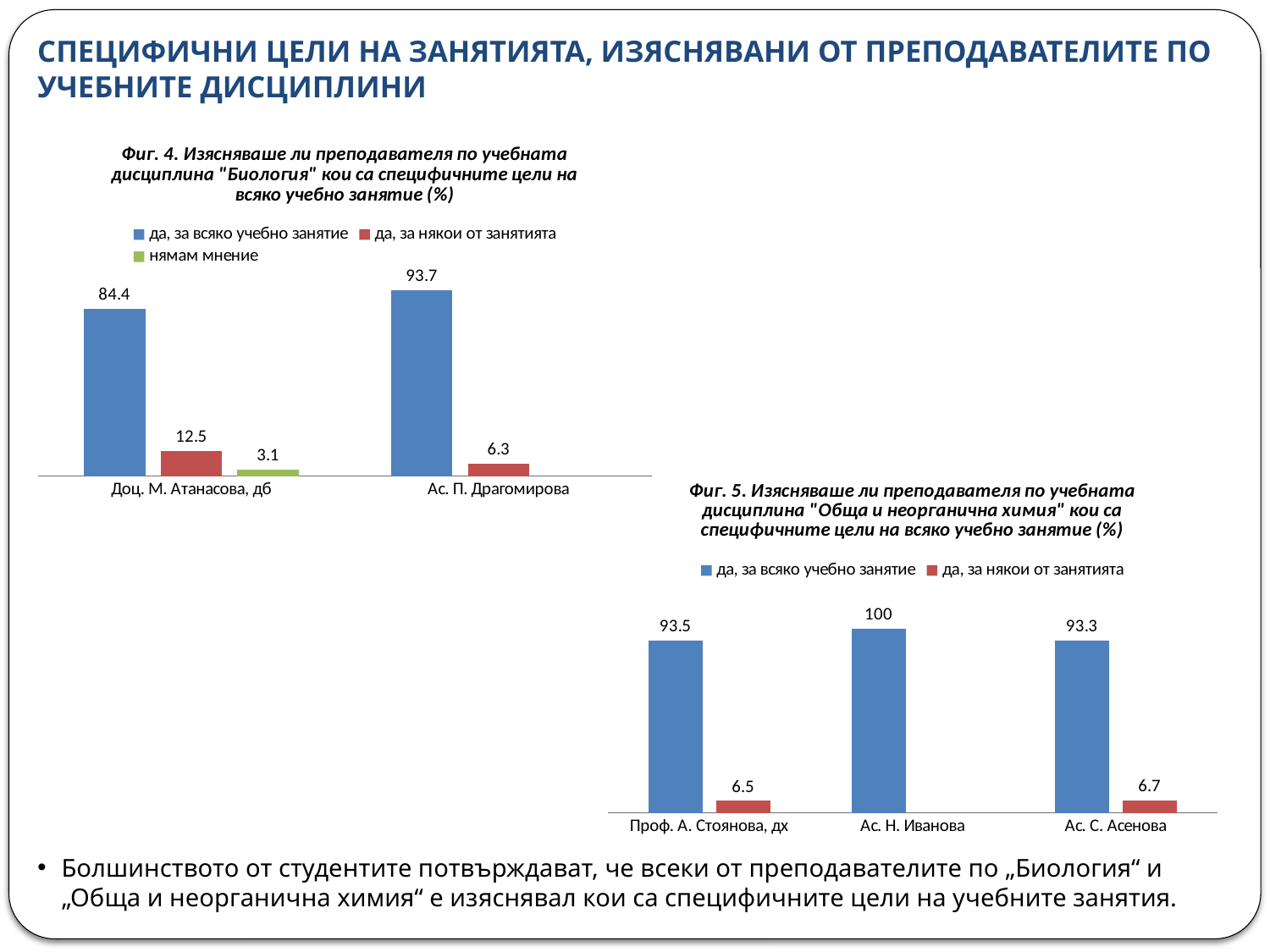
In Фиг. 5 (Обща и неорганична химия), what is the value of "да, за всяко учебно занятие" for Ас. Н. Иванова? 100 How many lecturers (categories) are shown in Фиг. 5 (Обща и неорганична химия)? 3 In Фиг. 4 (Биология), what is the difference between the "да, за всяко учебно занятие" values for Ас. П. Драгомирова and Доц. М. Атанасова, дб? 9.3 What type of chart is Фиг. 5 (Обща и неорганична химия)? Bar chart In Фиг. 4 (Биология), what is the value of "да, за някои от занятията" for Ас. П. Драгомирова? 6.3 In Фиг. 4 (Биология), what is the value of "нямам мнение" for Доц. М. Атанасова, дб? 3.1 In Фиг. 4 (Биология), what is the value of "да, за всяко учебно занятие" for Доц. М. Атанасова, дб? 84.4 How many series does the legend of Фиг. 4 (Биология) list? 3 In Фиг. 5 (Обща и неорганична химия), what is the difference between the "да, за всяко учебно занятие" values for Ас. Н. Иванова and Проф. А. Стоянова, дх? 6.5 In Фиг. 5 (Обща и неорганична химия), what is the value of "да, за някои от занятията" for Ас. С. Асенова? 6.7 In Фиг. 4 (Биология), which lecturer has the higher value for "да, за някои от занятията"? Доц. М. Атанасова, дб In Фиг. 5 (Обща и неорганична химия), which lecturer has the highest value for "да, за всяко учебно занятие"? Ас. Н. Иванова